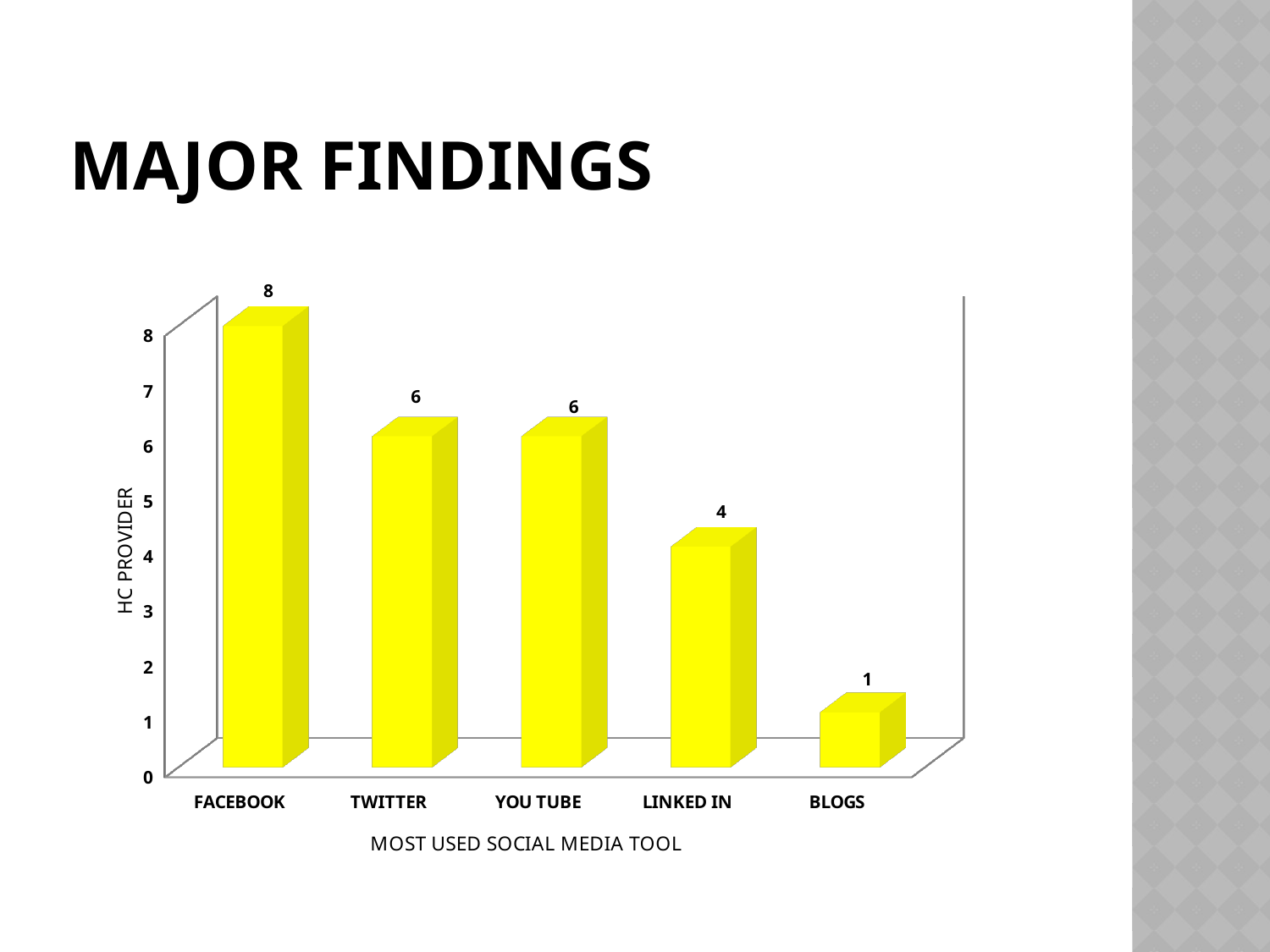
Which social media tool has the lowest value? BLOGS What is the difference between the values for YOU TUBE and BLOGS? 5 How many social media tools are shown on the x axis? 5 What kind of chart is shown on the slide? Bar chart Which is larger, the value for TWITTER or the value for LINKED IN? TWITTER What is the value for LINKED IN? 4 What is the difference between the values for FACEBOOK and LINKED IN? 4 What is the value for FACEBOOK? 8 What is the value for TWITTER? 6 Which social media tool has the highest value? FACEBOOK What is the label of the vertical axis? HC PROVIDER What is the value for BLOGS? 1